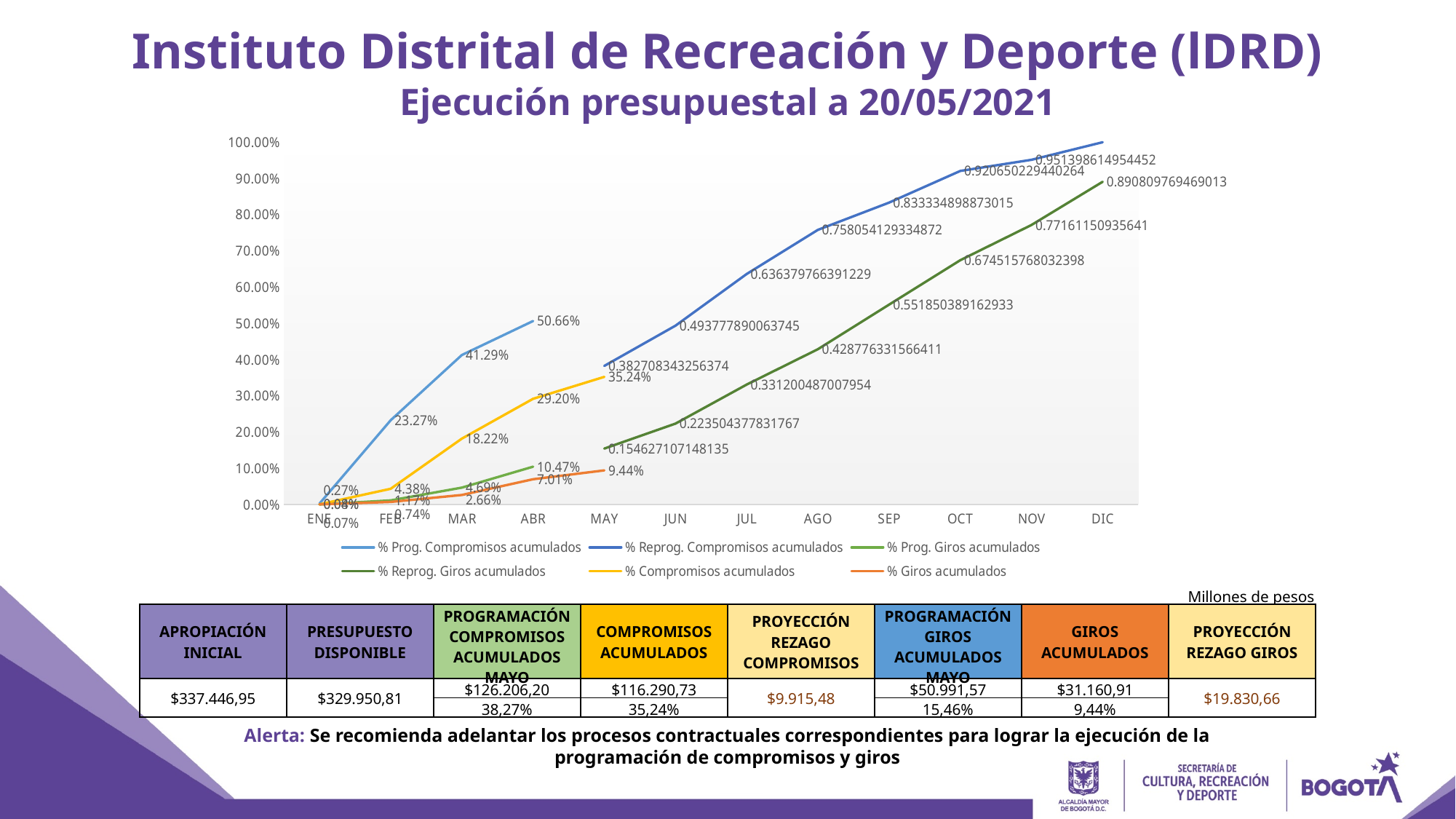
How many months are shown on the x axis of the chart? 12 What is the data label for % Reprog. Compromisos acumulados in NOV? 0.951398614954452 What kind of chart is shown on the slide? line chart In ABR, what is the difference between % Prog. Compromisos acumulados and % Compromisos acumulados? 21.46 percentage points What is the value of % Compromisos acumulados in MAY? 35.24% In MAR, which is larger: % Prog. Compromisos acumulados or % Compromisos acumulados? % Prog. Compromisos acumulados What is the value of % Prog. Giros acumulados in ABR? 10.47% How many series does the chart legend list? 6 What is the value of % Giros acumulados in MAY? 9.44% What is the data label for % Reprog. Giros acumulados in DIC? 0.890809769469013 Does the % Reprog. Giros acumulados line rise or fall from MAY to DIC? rise What is the value of % Prog. Compromisos acumulados in ABR? 50.66%